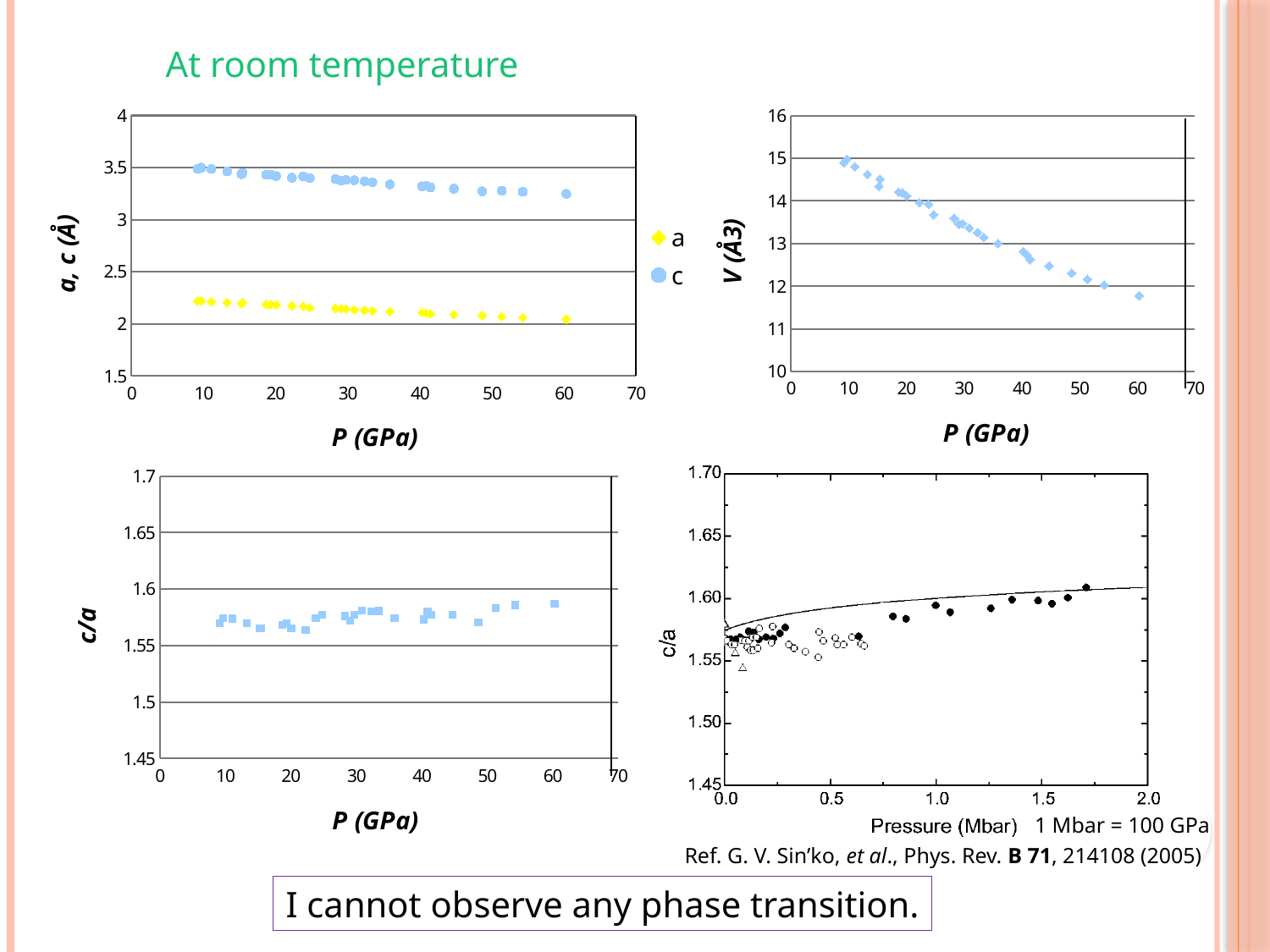
In the top-left chart (a, c vs P), is the value of a at 10 GPa greater or less than 2.5? less In the bottom-left chart (c/a vs P), is the value of c/a at 60 GPa greater or less than 1.6? less In the top-right chart (V vs P), is the value of V at 60 GPa greater or less than 12? less In the top-left chart (a, c vs P), what are the two series named in the legend? a and c In the bottom-right chart (c/a vs Pressure in Mbar), do the filled-circle values rise or fall as pressure increases? rise In the top-left chart (a, c vs P), how many series does the legend list? 2 In the bottom-left chart (c/a vs P), what kind of chart is it? scatter chart In the top-left chart (a, c vs P), which series has the larger values, a or c? c In the top-left chart (a, c vs P), do the values of c rise or fall as pressure increases? fall In the top-right chart (V vs P), do the values of V rise or fall as pressure increases? fall